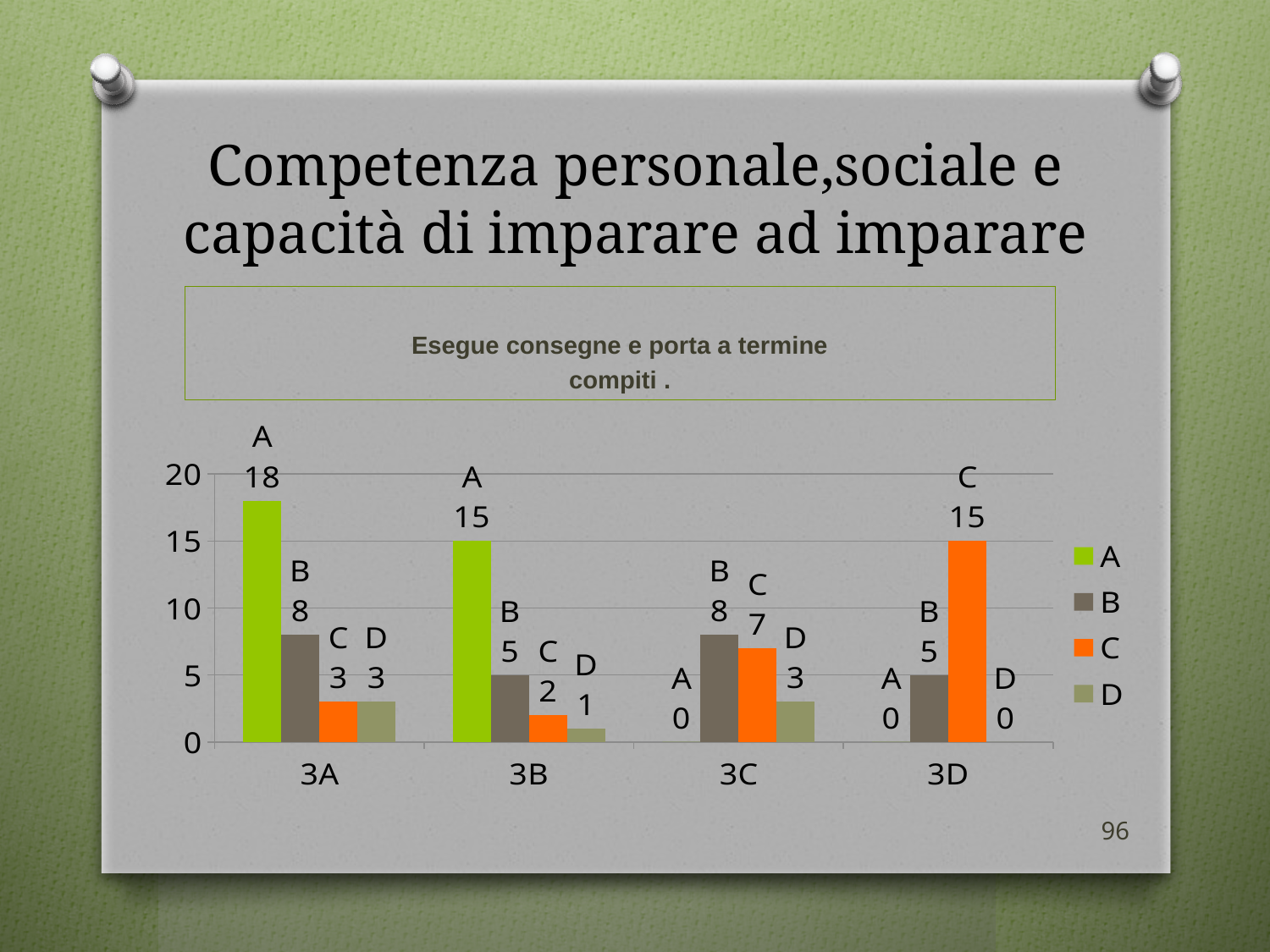
How many categories are shown on the x axis? 4 How many series does the legend list? 4 What is the difference between the value of series A for 3A and the value of series A for 3B? 3 What is the value of series D for category 3B? 1 What is the value of series B for category 3C? 8 What kind of chart is shown on the slide? bar chart Which category has the lowest value for series C? 3B What is the value of series C for category 3D? 15 Which is larger: the value of series C for 3C or the value of series B for 3D? C for 3C Which category has the highest value for series A? 3A What is the title shown in the box above the chart? Esegue consegne e porta a termine compiti . What is the value of series A for category 3A? 18